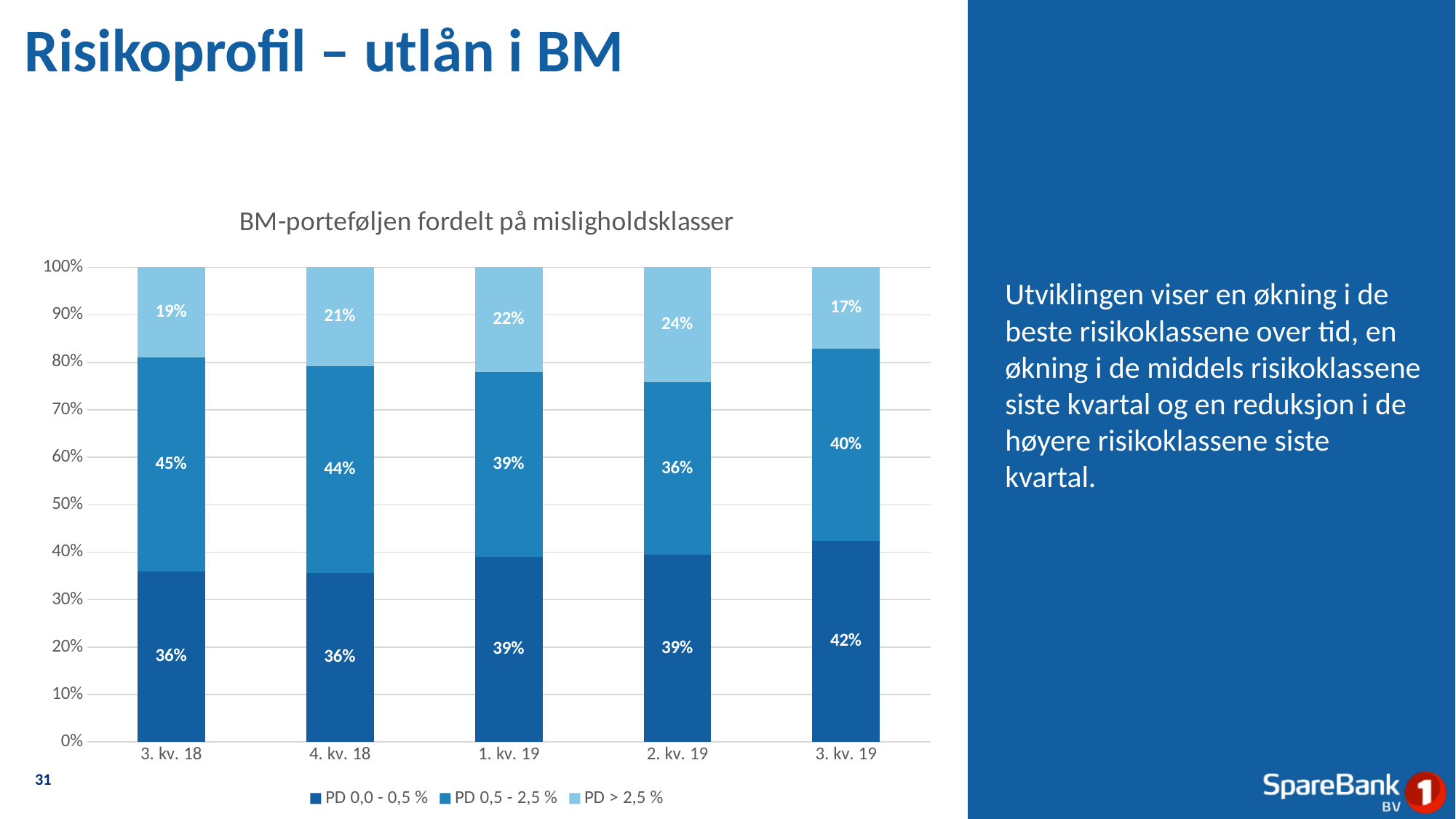
What is the difference between the PD 0,5 - 2,5 % value for 3. kv. 18 and for 2. kv. 19? 9 percentage points What is the value of the PD 0,5 - 2,5 % series for 4. kv. 18? 44% Which is larger: the PD 0,0 - 0,5 % value for 3. kv. 18 or for 1. kv. 19? 1. kv. 19 What is the title of the chart? BM-porteføljen fordelt på misligholdsklasser Does the PD 0,0 - 0,5 % share rise or fall from 3. kv. 18 to 3. kv. 19? Rise What kind of chart is shown on the slide? Stacked bar chart What is the value of the PD 0,0 - 0,5 % series for 3. kv. 19? 42% In which quarter is the PD > 2,5 % share lowest? 3. kv. 19 In which quarter is the PD > 2,5 % share highest? 2. kv. 19 What is the value of the PD > 2,5 % series for 2. kv. 19? 24% How many series does the legend list? 3 How many quarters are shown on the x axis? 5